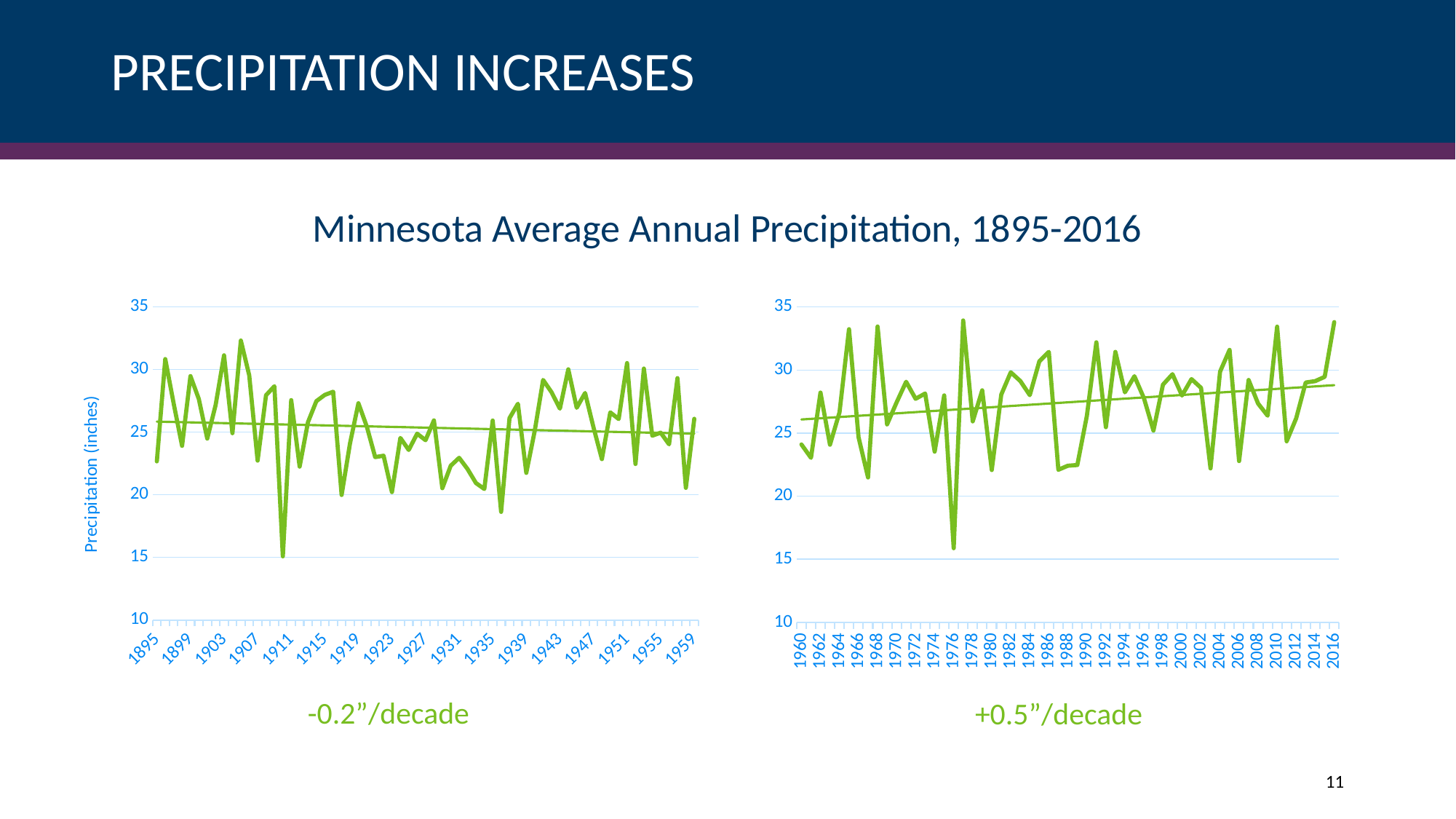
In the left chart (1895-1959), does the trend line rise or fall across the years? fall In the left chart (1895-1959), is the value for 1911 greater or less than 20? greater What kind of chart is used on the left side of the slide? line chart In the right chart (1960-2016), is the value for 2016 greater or less than 30? greater In the right chart (1960-2016), which year has the lowest precipitation? 1976 In the right chart (1960-2016), does the trend line rise or fall across the years? rise What is the title shared by the two charts on the slide? Minnesota Average Annual Precipitation, 1895-2016 In the left chart (1895-1959), which year has the lowest precipitation? 1910 What is the y-axis label on the left chart? Precipitation (inches) In the right chart (1960-2016), is the value for 1976 greater or less than 20? less In the right chart (1960-2016), which year has the higher precipitation, 1976 or 1977? 1977